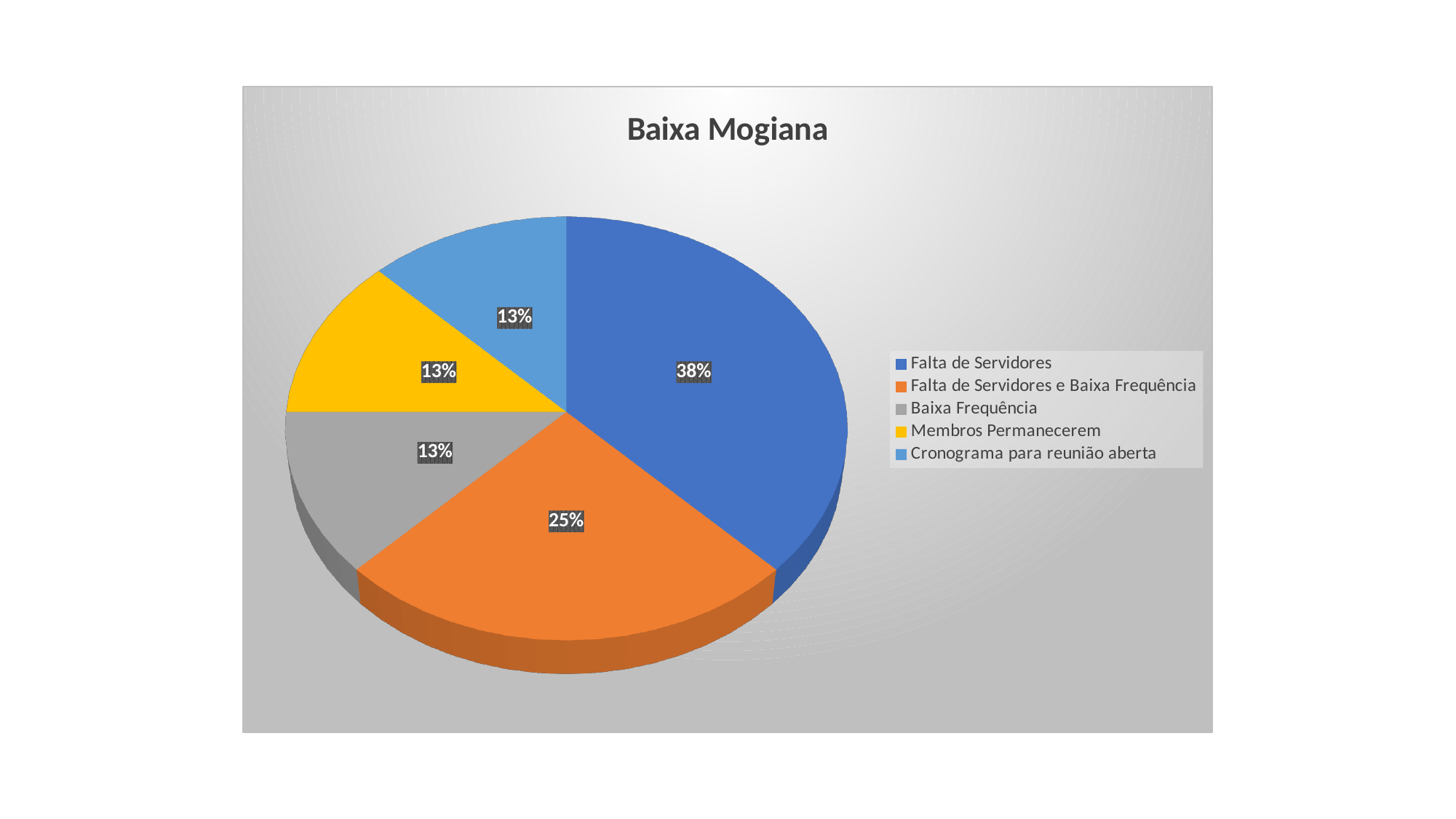
What share of the pie does Baixa Frequência represent? 13% What is the title of the chart? Baixa Mogiana What colour is the slice for Membros Permanecerem? Yellow What is the difference in percentage points between the Falta de Servidores slice and the Baixa Frequência slice? 25 percentage points How many categories does the legend list? 5 What share of the pie does Membros Permanecerem represent? 13% Which is larger, the slice for Falta de Servidores or the slice for Falta de Servidores e Baixa Frequência? Falta de Servidores What share of the pie does Falta de Servidores represent? 38% Which category has the largest slice of the pie? Falta de Servidores What type of chart is shown on the slide? Pie chart